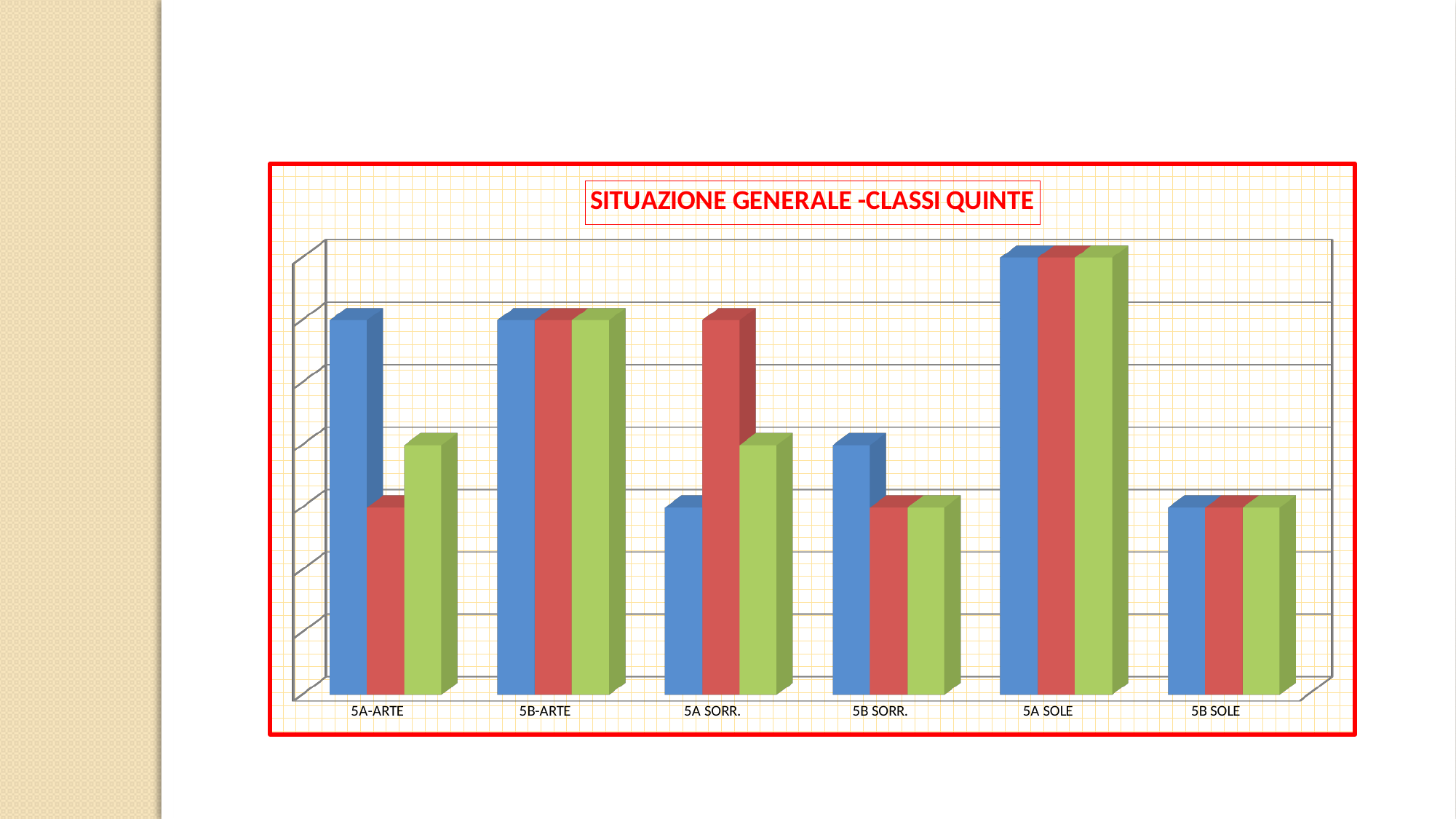
Is the green bar for 5B-ARTE taller or shorter than the green bar for 5B SOLE? taller What type of chart is shown on the slide? bar chart How many bars are plotted for each category in the chart? 3 How many categories are shown on the x axis of the chart? 6 Which category has the tallest blue bar? 5A SOLE Is the blue bar for 5A-ARTE taller or shorter than the blue bar for 5B SORR.? taller Within the 5A-ARTE category, which coloured bar is the shortest? red Which category has the tallest bars in the chart? 5A SOLE Is the red bar for 5A SORR. taller or shorter than the red bar for 5B SORR.? taller What is the title of the chart? SITUAZIONE GENERALE -CLASSI QUINTE Within the 5A SORR. category, which coloured bar is the tallest? red